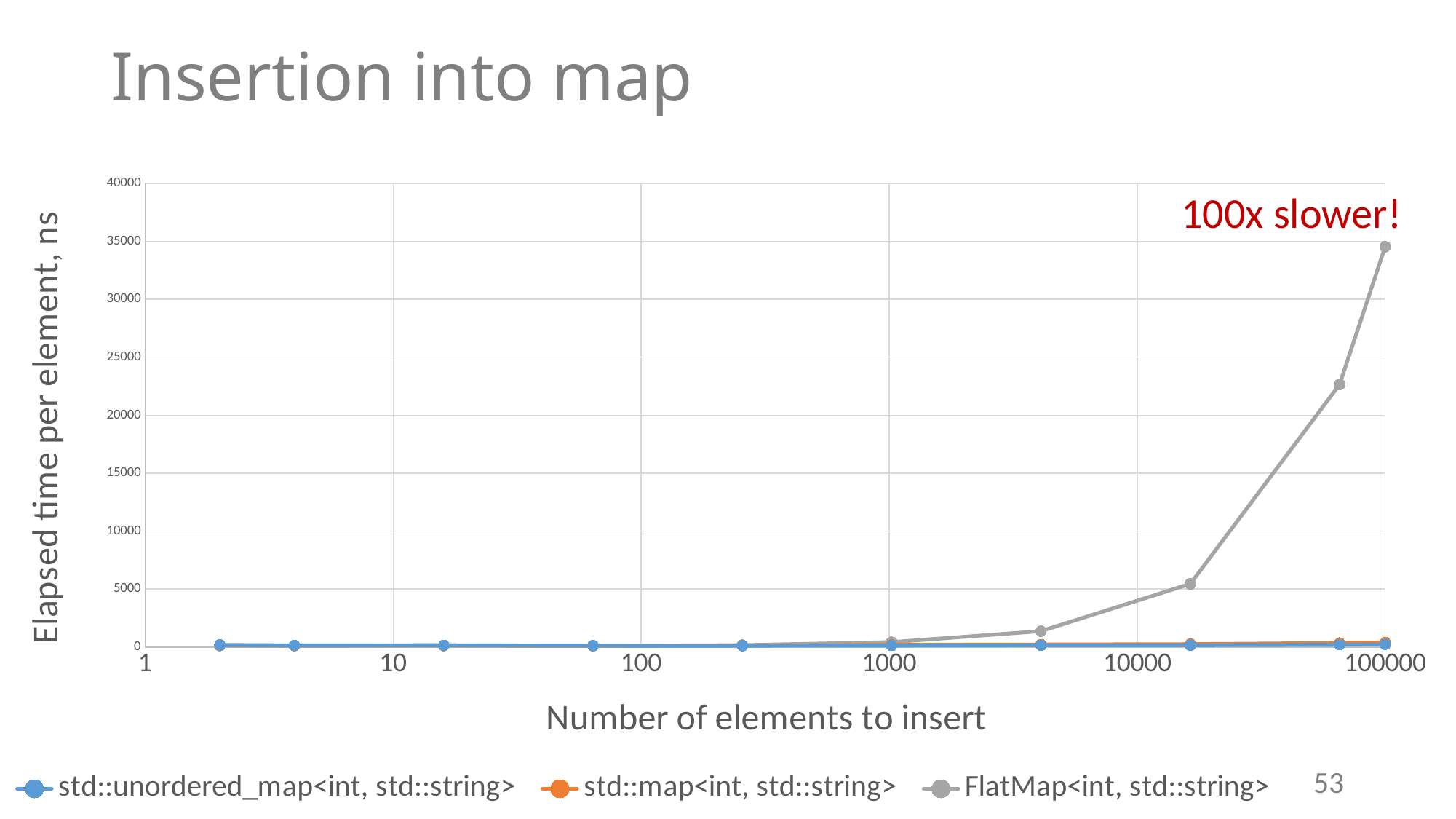
What kind of chart is shown on the slide? line chart What is the title of the chart on the slide? Insertion into map Which series has the highest elapsed time at 100000 elements? FlatMap<int, std::string> How many data points are plotted for the FlatMap<int, std::string> series? 10 Which is larger at 100000 elements: FlatMap<int, std::string> or std::unordered_map<int, std::string>? FlatMap<int, std::string> Is the value for FlatMap<int, std::string> at its second-to-last point (around 65000 elements) greater or less than 20000? greater Does the FlatMap<int, std::string> series rise or fall as the number of elements increases? rise What annotation text is written in red near the top right of the chart? 100x slower! How many series does the legend list? 3 Is the value for std::map<int, std::string> at 100000 elements greater or less than 5000? less Is the value for FlatMap<int, std::string> at 100000 elements greater or less than 30000? greater